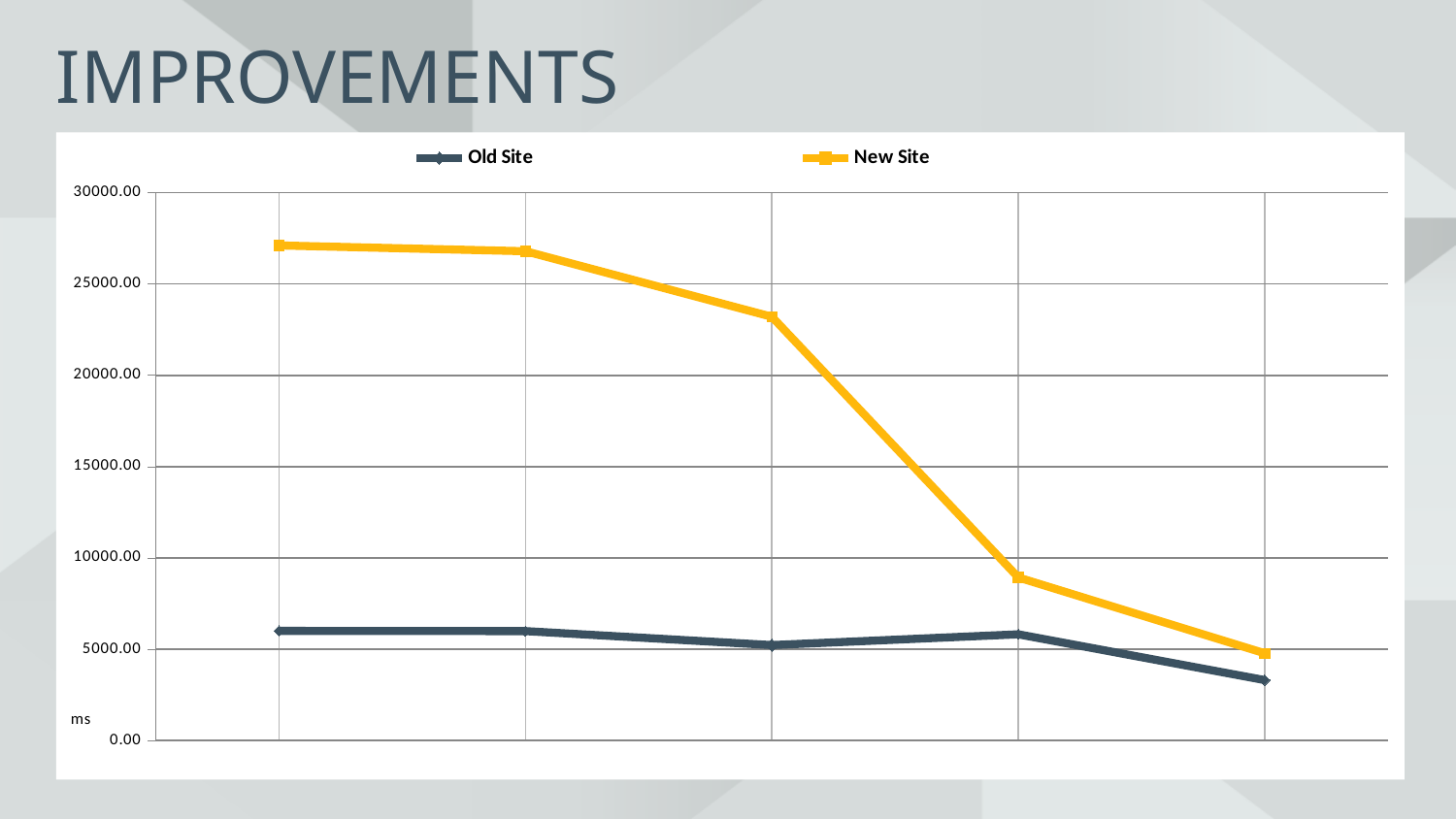
How many series does the legend list? 2 Is the first (leftmost) value of the New Site line greater or less than 25000.00? greater At the leftmost point, which series has the higher value, Old Site or New Site? New Site How many data points does the New Site line have? 5 What are the two series named in the legend? Old Site and New Site What kind of chart is shown on the slide? line chart Is the first (leftmost) value of the Old Site line greater or less than 5000.00? greater Is the last (rightmost) value of the Old Site line greater or less than 5000.00? less Does the New Site line rise or fall from left to right? fall What unit is shown on the vertical axis? ms